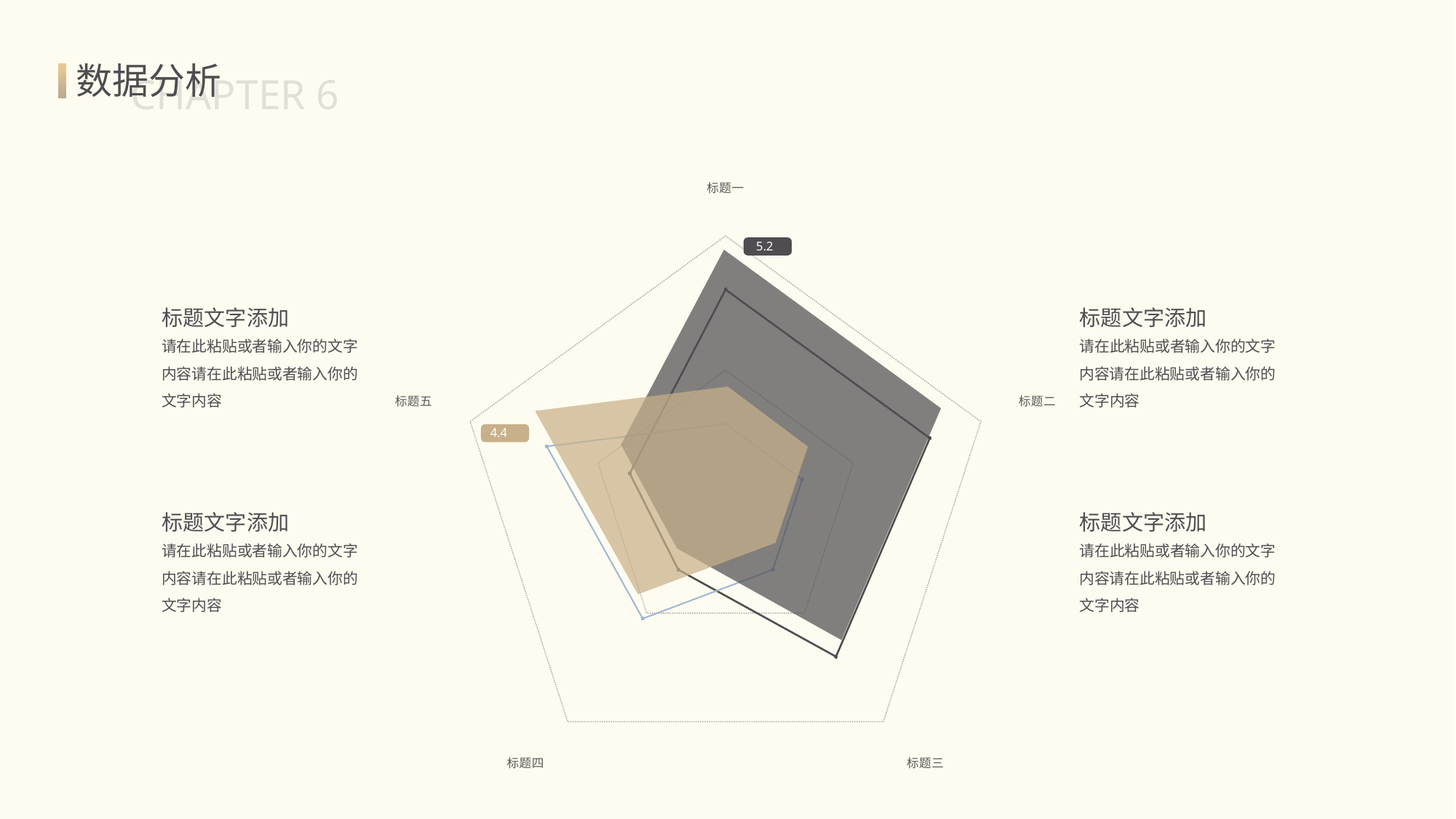
What value is labelled on the radar chart near the 标题五 axis? 4.4 Which category label sits at the bottom-left of the radar chart? 标题四 What kind of chart is shown on the slide? Radar chart What is the difference between the two labelled values on the radar chart, 5.2 and 4.4? 0.8 What value is labelled on the radar chart near the 标题一 axis? 5.2 Which is larger, the value labelled near 标题一 (5.2) or the value labelled near 标题五 (4.4)? 5.2 How many categories (axes) does the radar chart have? 5 Which category label sits at the top of the radar chart? 标题一